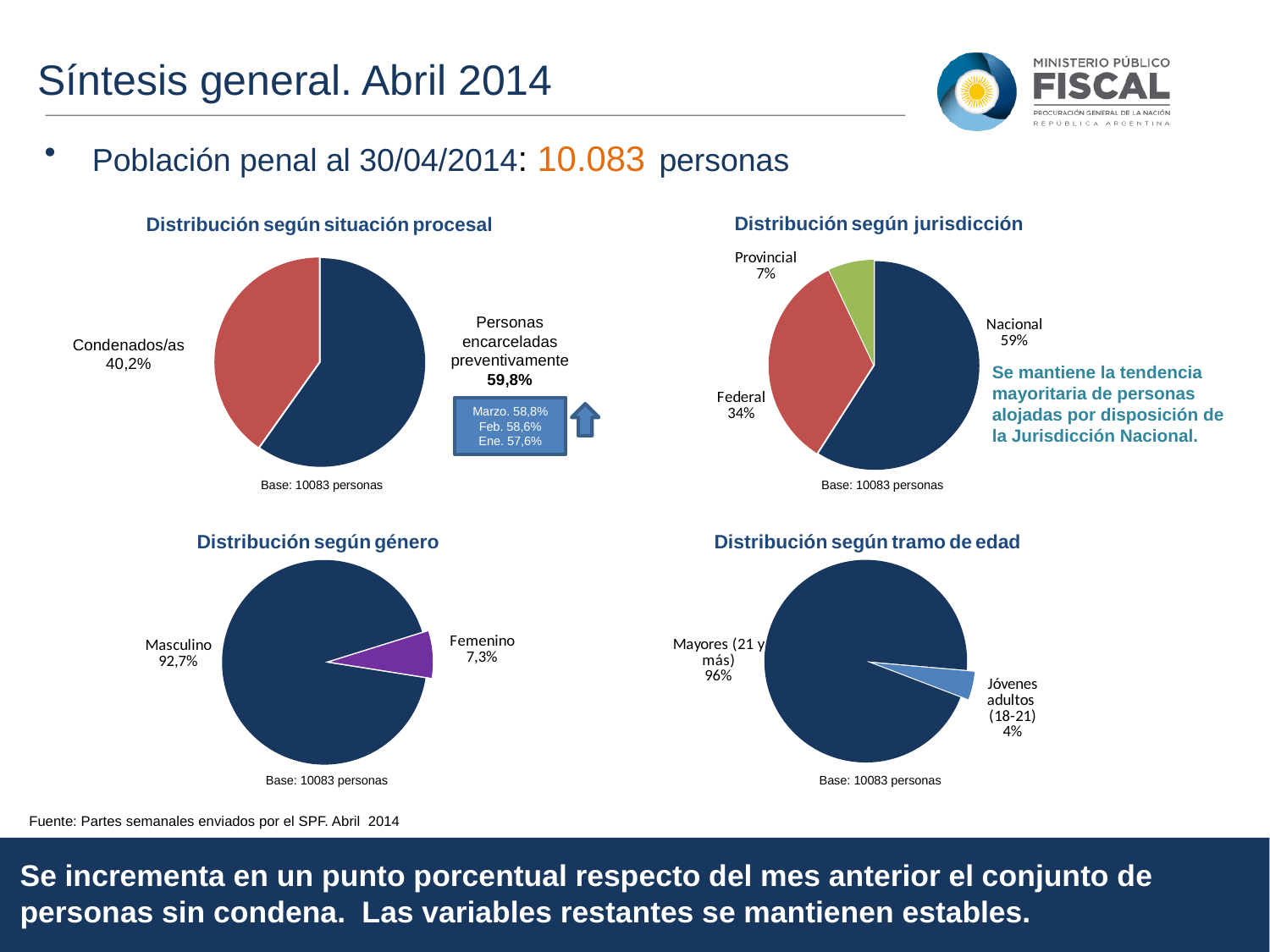
In the chart 'Distribución según jurisdicción', which category has the smallest slice? Provincial In the chart 'Distribución según género', which is larger, Masculino or Femenino? Masculino In the chart 'Distribución según jurisdicción', what percentage is shown for Federal? 34% In the chart 'Distribución según género', what percentage is shown for Femenino? 7,3% What base (number of persons) is stated below the chart 'Distribución según género'? 10083 personas In the chart 'Distribución según situación procesal', what share of the pie is 'Personas encarceladas preventivamente'? 59,8% In the chart 'Distribución según situación procesal', what percentage is shown for Condenados/as? 40,2% In the chart 'Distribución según jurisdicción', which category has the largest slice? Nacional In the chart 'Distribución según jurisdicción', what is the difference in percentage points between Nacional and Federal? 25 How many categories does the chart 'Distribución según jurisdicción' show? 3 What kind of chart is 'Distribución según tramo de edad'? Pie chart In the chart 'Distribución según tramo de edad', what percentage is shown for Jóvenes adultos (18-21)? 4%